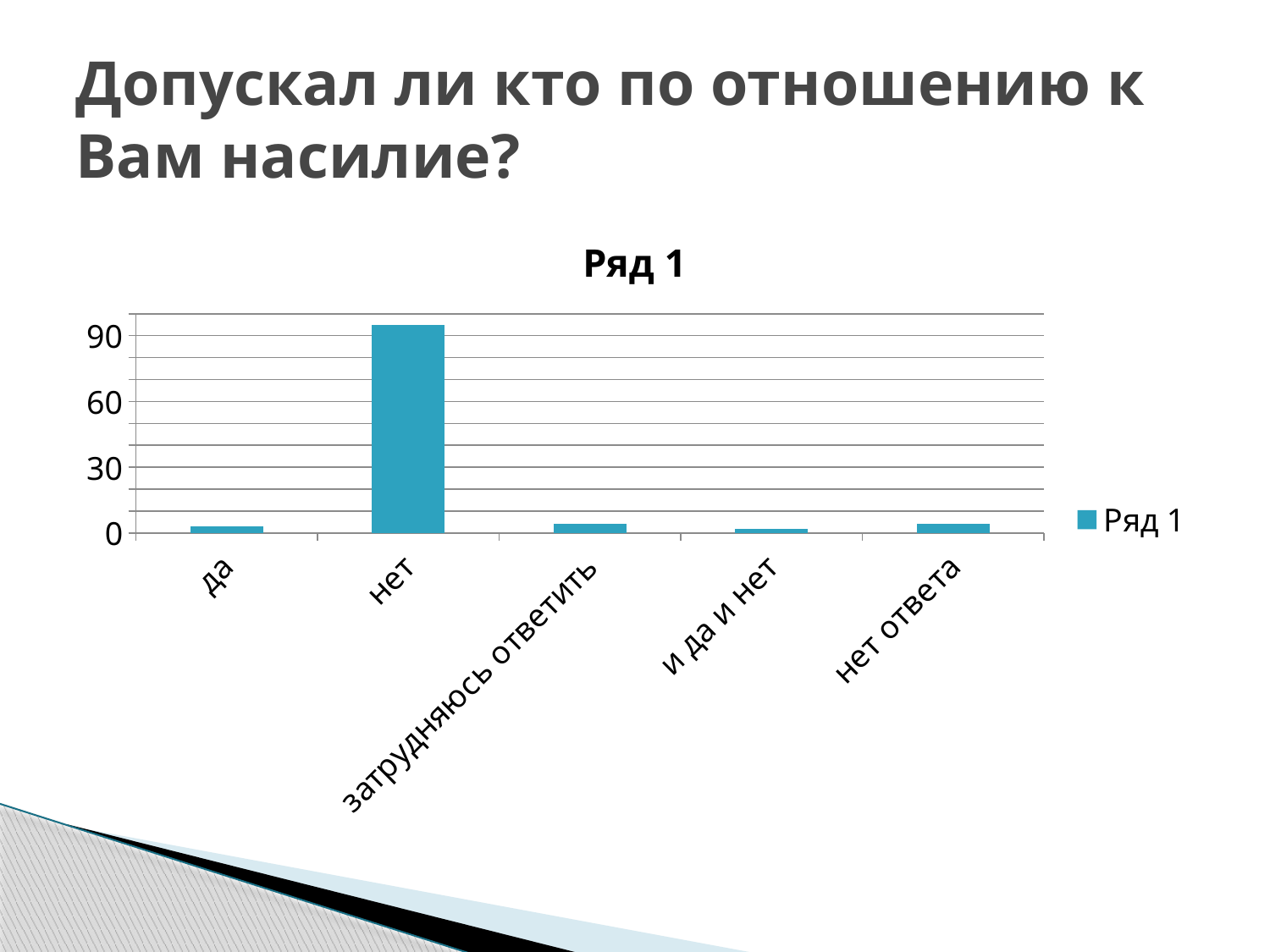
How many series does the legend list? 1 What is the title of the chart? Ряд 1 How many categories are shown on the x axis of the chart? 5 Which is larger, the value for "нет" or the value for "да"? нет What kind of chart is shown on the slide? bar chart Is the value for "нет ответа" greater or less than 30? less What is the name of the series shown in the legend? Ряд 1 Is the value for "затрудняюсь ответить" greater or less than 30? less Is the value for "да" greater or less than 30? less Which category has the highest value? нет Which is larger, the value for "и да и нет" or the value for "нет"? нет